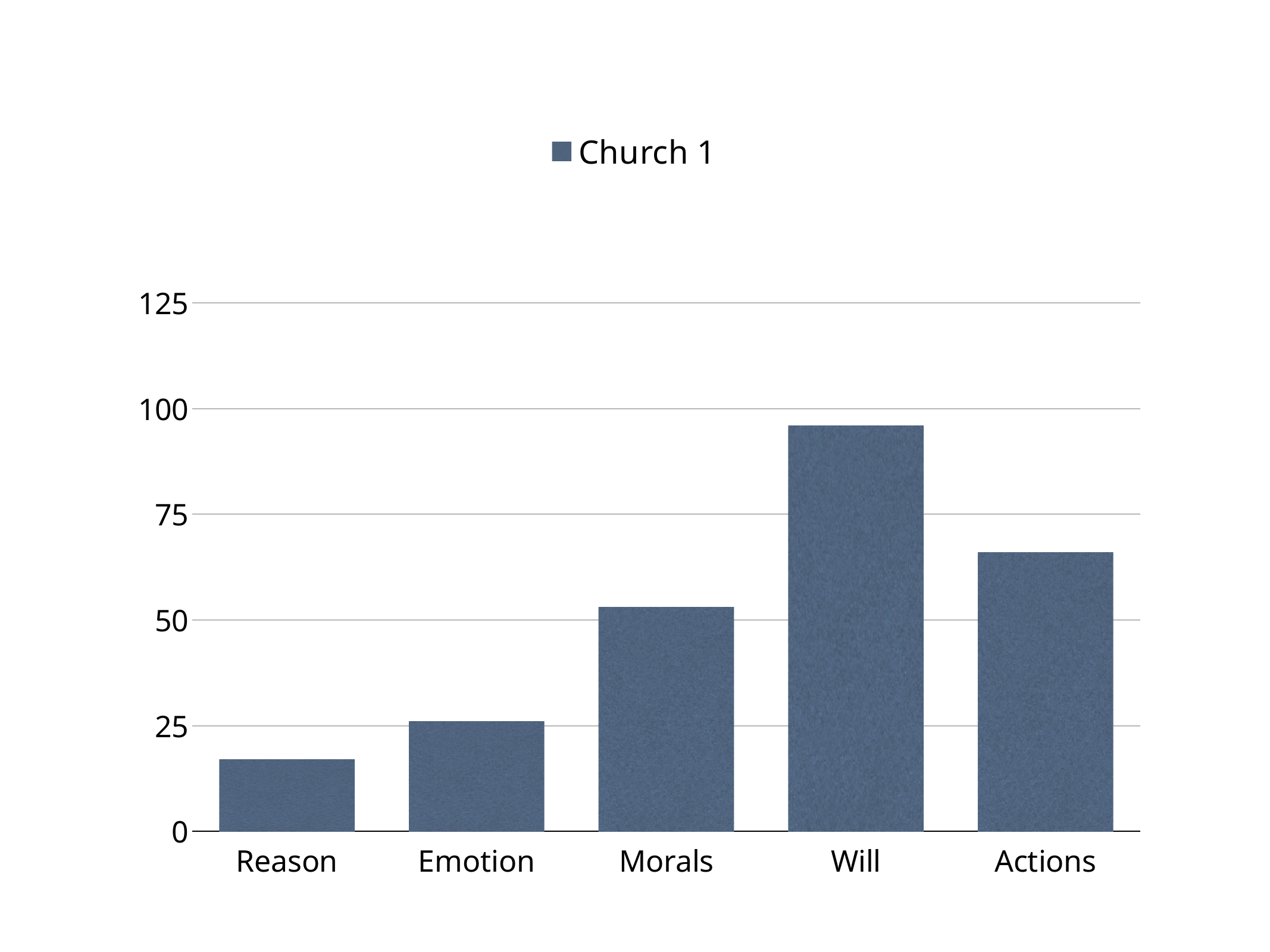
Which is larger, the value for Emotion or the value for Reason? Emotion Is the value for Will greater or less than 75? greater Which category has the lowest value? Reason How many categories are shown on the x axis? 5 What kind of chart is shown on the slide? bar chart Is the value for Actions greater or less than 75? less Which category has the highest value? Will Which is larger, the value for Morals or the value for Actions? Actions What is the name of the series shown in the legend? Church 1 How many series does the legend list? 1 Is the value for Reason greater or less than 25? less